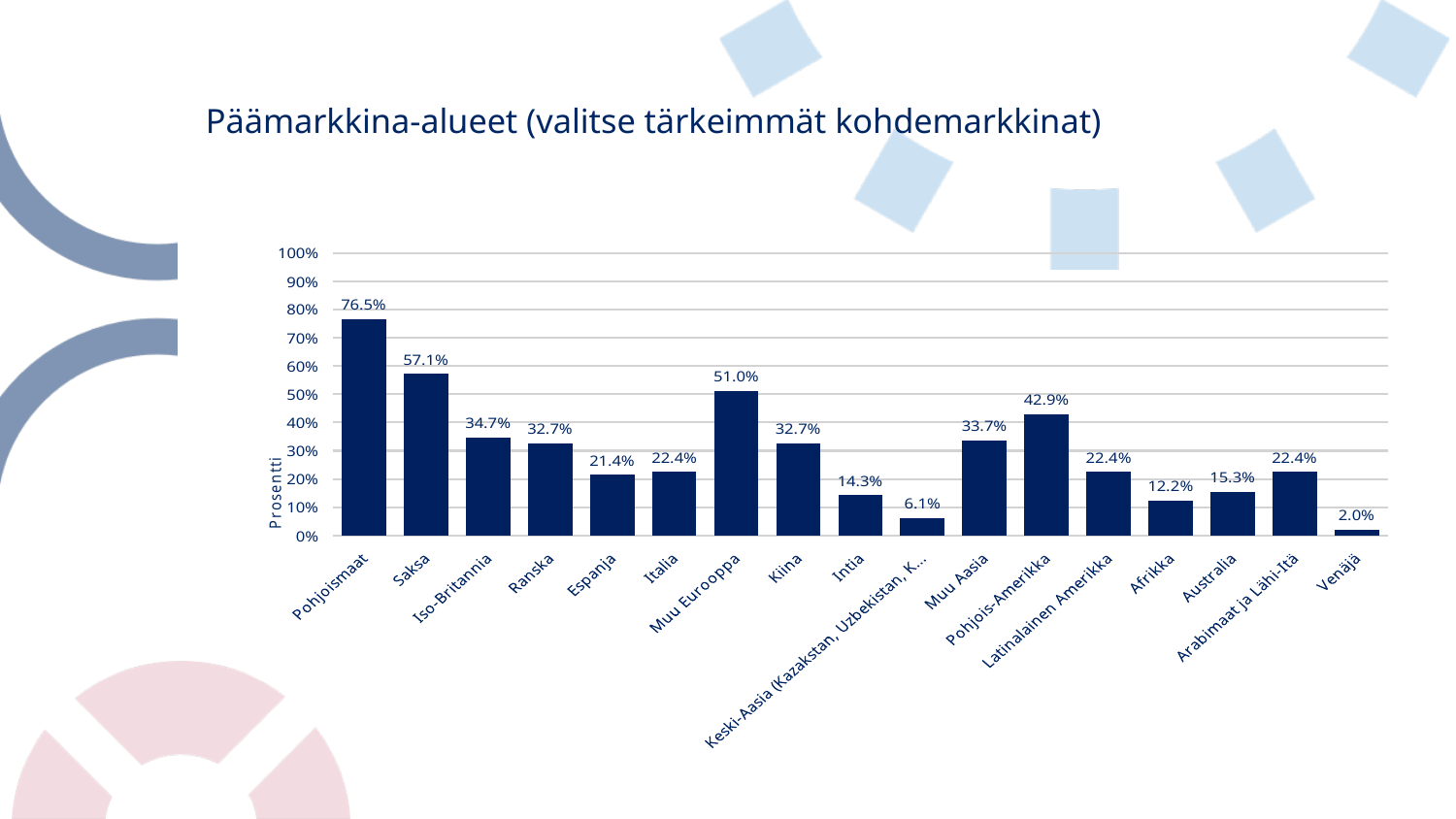
Which is larger, the value for Iso-Britannia or the value for Muu Aasia? Iso-Britannia Is the value for Kiina greater or less than 30%? greater What is the value for Afrikka? 12.2% What is the value for Pohjoismaat? 76.5% What is the label on the vertical axis? Prosentti What is the value for Muu Eurooppa? 51.0% Which category has the highest value? Pohjoismaat What is the value for Pohjois-Amerikka? 42.9% What kind of chart is shown on the slide? bar chart How many categories are shown on the x axis? 17 Which category has the lowest value? Venäjä What is the difference between the values for Pohjoismaat and Saksa? 19.4%